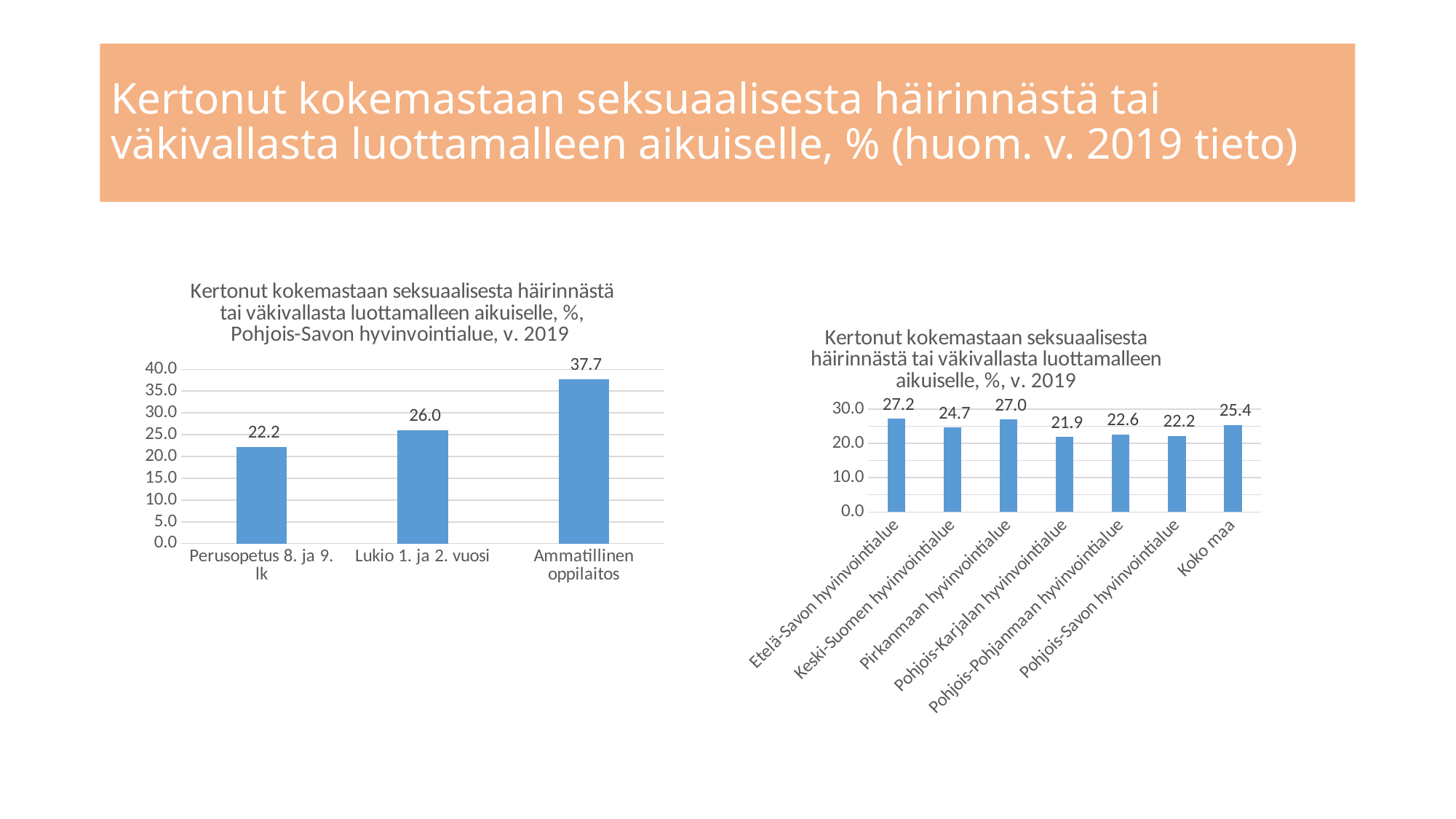
In the right chart (v. 2019, all regions), what is the difference between Pirkanmaan hyvinvointialue and Pohjois-Savon hyvinvointialue? 4.8 In the right chart (v. 2019, all regions), how many categories are shown? 7 In the right chart (v. 2019, all regions), which region has the highest value? Etelä-Savon hyvinvointialue In the left chart (Pohjois-Savon hyvinvointialue), what is the value for Ammatillinen oppilaitos? 37.7 In the right chart (v. 2019, all regions), what is the value for Pohjois-Karjalan hyvinvointialue? 21.9 In the left chart (Pohjois-Savon hyvinvointialue), what is the difference between Ammatillinen oppilaitos and Lukio 1. ja 2. vuosi? 11.7 In the left chart (Pohjois-Savon hyvinvointialue), what is the value for Perusopetus 8. ja 9. lk? 22.2 In the left chart (Pohjois-Savon hyvinvointialue), which category has the lowest value? Perusopetus 8. ja 9. lk In the right chart (v. 2019, all regions), which is larger: Keski-Suomen hyvinvointialue or Pohjois-Pohjanmaan hyvinvointialue? Keski-Suomen hyvinvointialue In the left chart (Pohjois-Savon hyvinvointialue), what kind of chart is it? Bar chart In the right chart (v. 2019, all regions), what is the value for Koko maa? 25.4 In the left chart (Pohjois-Savon hyvinvointialue), how many categories are shown? 3